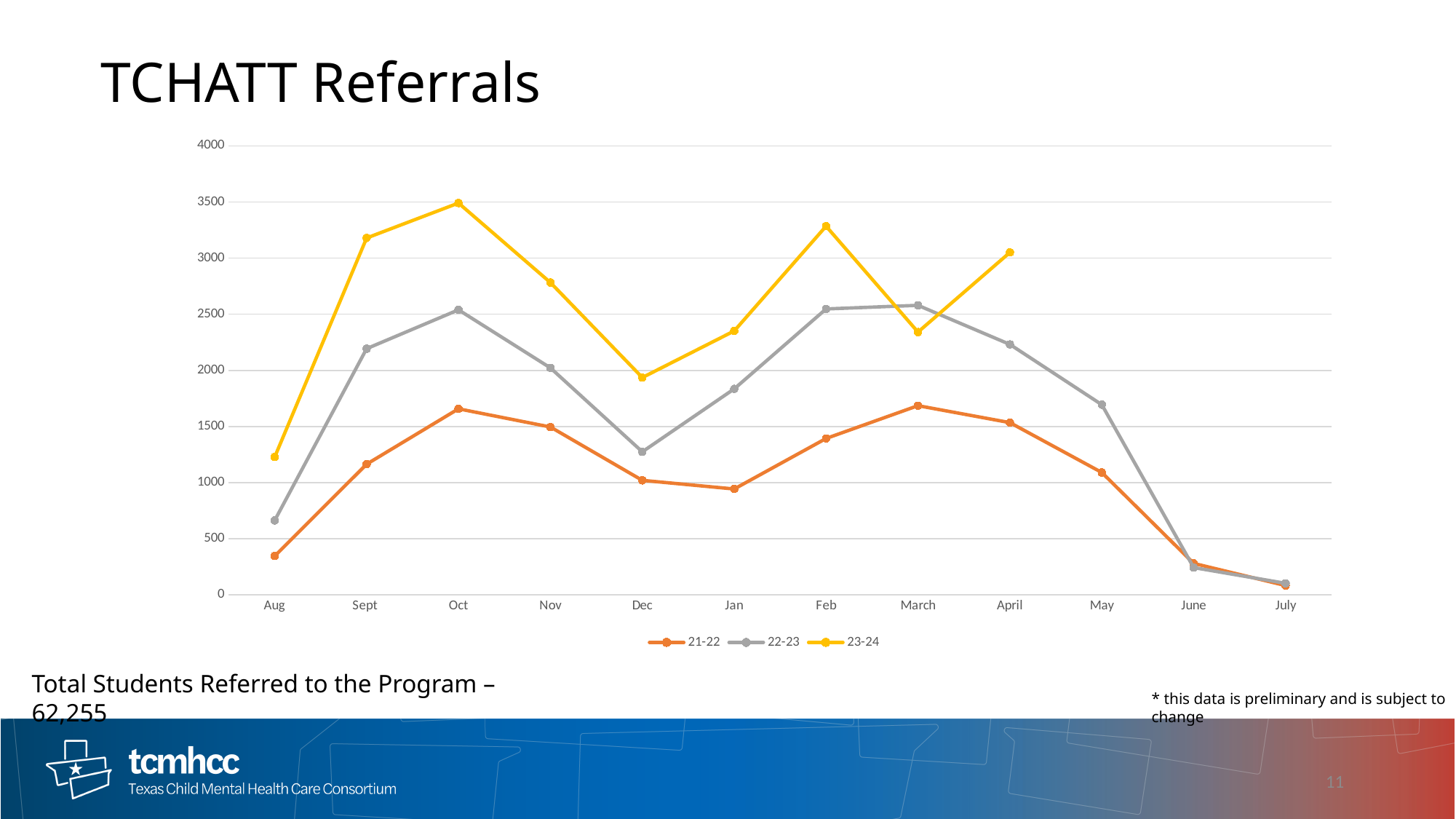
Does the 22-23 series rise or fall from March to July? fall In which month does the 22-23 series reach its highest value? March What kind of chart is shown on the slide? line chart Is the value for 23-24 in Oct greater or less than 3000? greater In which month does the 23-24 series reach its highest value? Oct How many months are shown along the x axis? 12 Is the value for 21-22 in Aug greater or less than 500? less In which month is the 21-22 series lowest? July Which colour is used for the 23-24 series? yellow Which series has the higher value in Feb, 22-23 or 23-24? 23-24 Is the value for 22-23 in Dec greater or less than 1500? less How many series does the legend list? 3